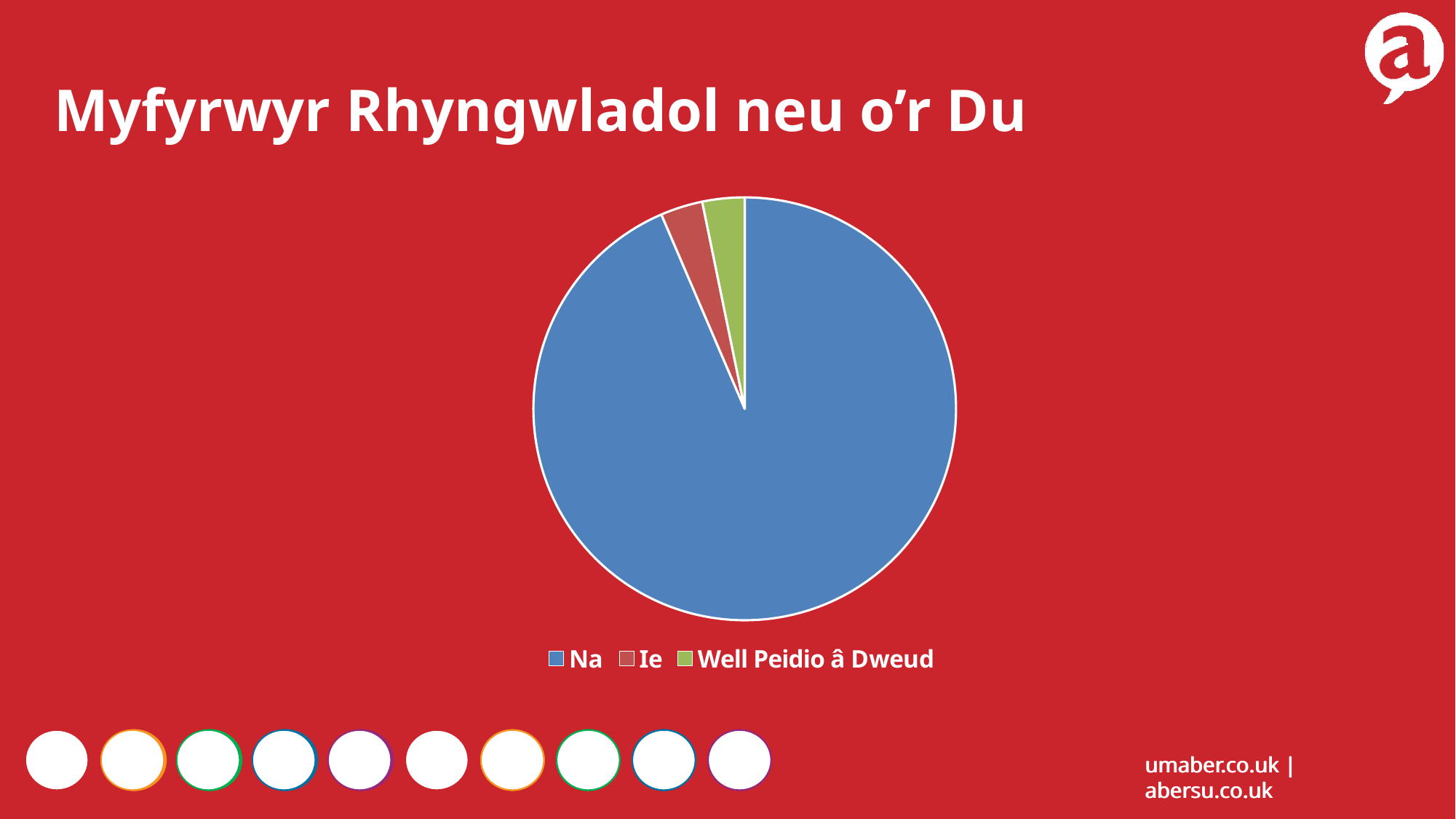
Which is larger, the slice for Na or the slice for Ie? Na What is the title of the slide containing the pie chart? Myfyrwyr Rhyngwladol neu o’r Du What kind of chart is shown on the slide? pie chart Which category has the largest slice of the pie? Na What colour is the slice for Well Peidio â Dweud? green How many entries does the legend list? 3 How many slices does the pie chart have? 3 Which is larger, the slice for Na or the slice for Well Peidio â Dweud? Na